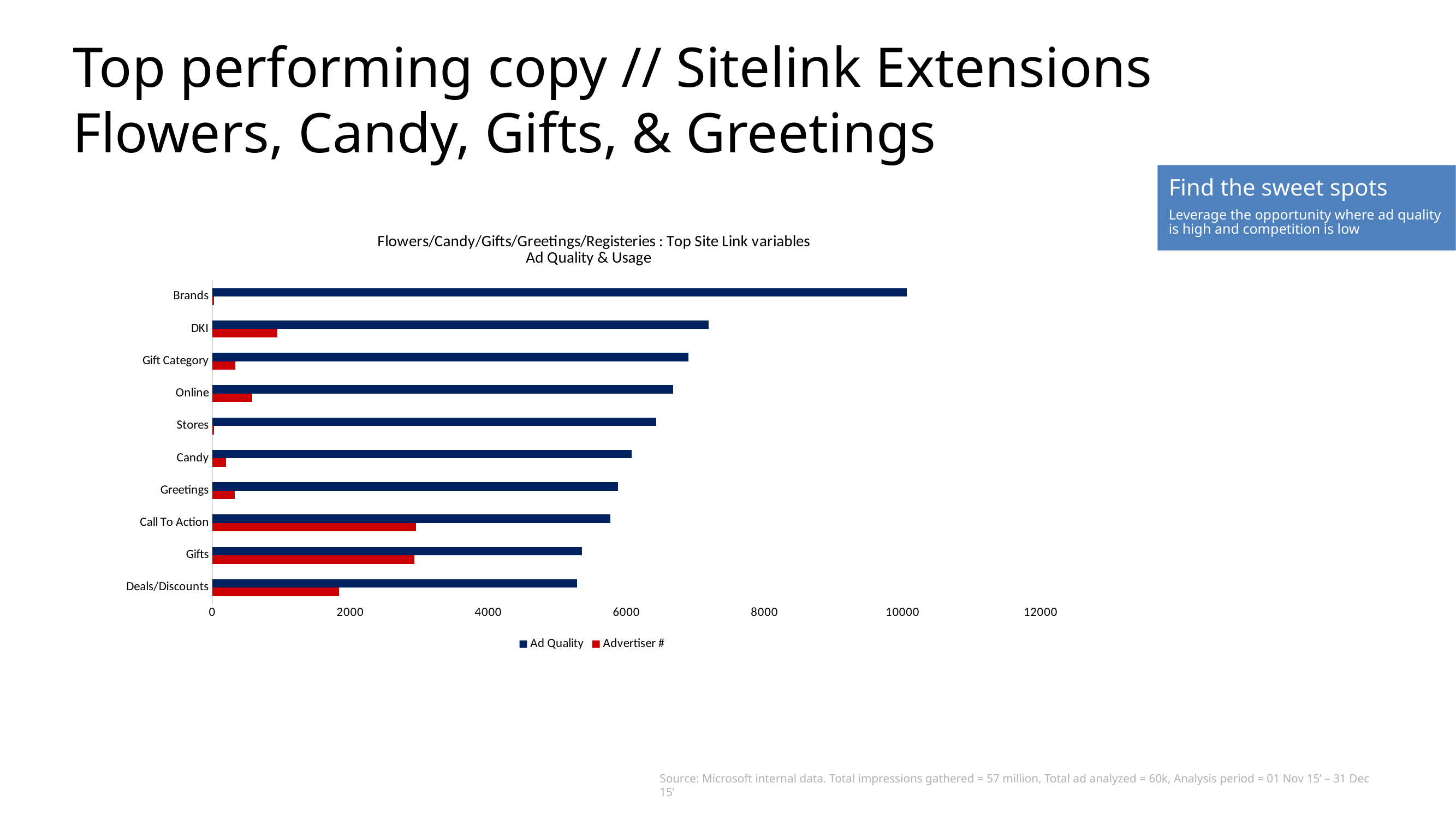
Is the Advertiser # value for Deals/Discounts greater or less than 2000? less Is the Ad Quality value for Gifts greater or less than 6000? less Is the Ad Quality value for Brands greater or less than 8000? greater Which series is shown in red in the chart's legend? Advertiser # Which category has the highest Ad Quality value? Brands Which has the larger Ad Quality value, Online or Candy? Online Which has the larger Advertiser # value, DKI or Candy? DKI Which has the larger Ad Quality value, Brands or DKI? Brands How many series does the chart's legend list? 2 How many categories are plotted on the chart? 10 What kind of chart is shown on the slide? Bar chart